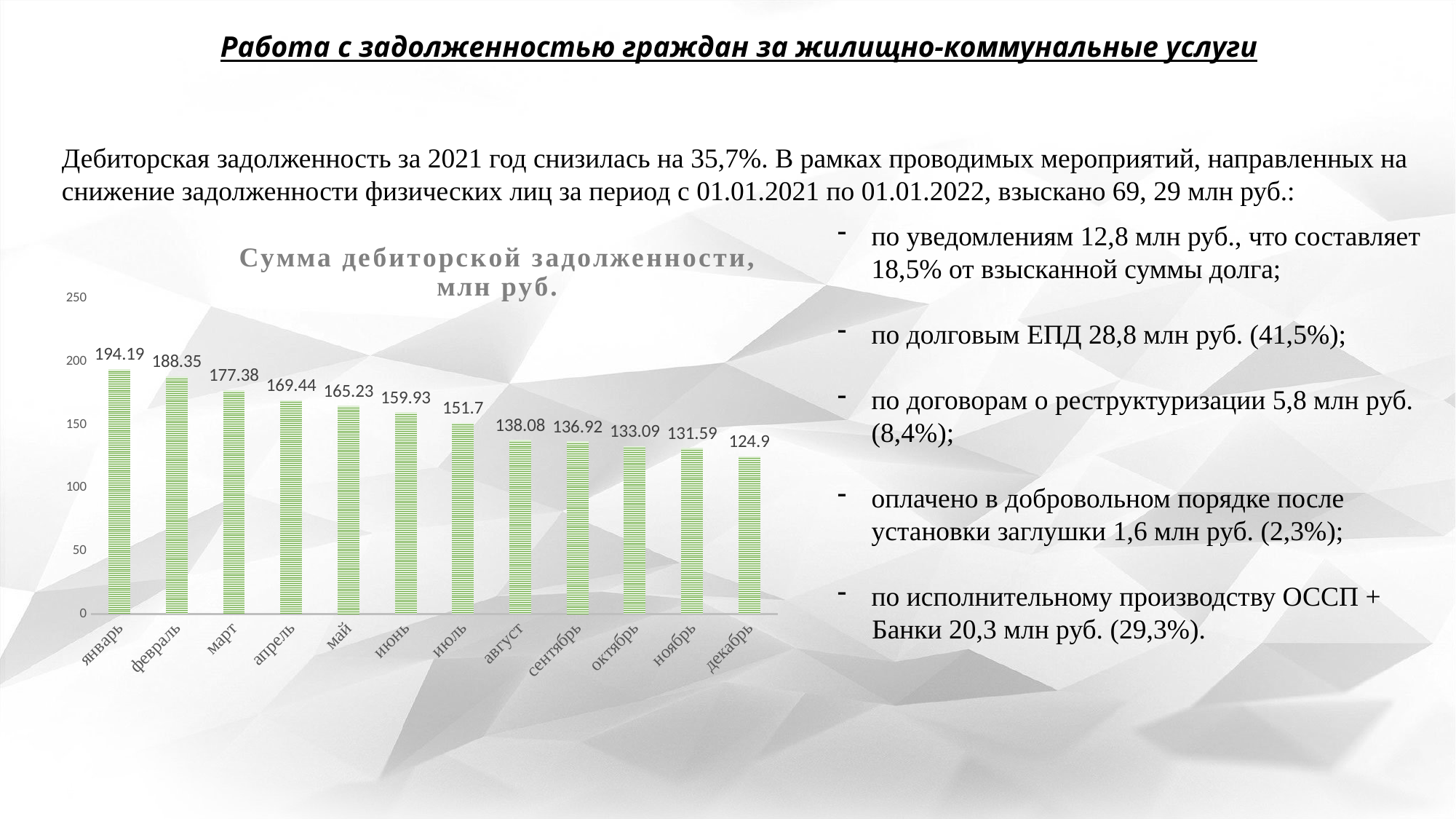
What is the difference between the values for январь and декабрь? 69.29 What is the value for декабрь? 124.9 Which is larger, the value for март or the value for май? март What kind of chart is shown? bar chart Which month has the lowest value? декабрь What is the value for июль? 151.7 Do the values rise or fall from январь to декабрь? fall Is the value for август greater or less than 150? less How many months are shown on the x axis? 12 What is the title of the chart? Сумма дебиторской задолженности, млн руб. What is the value for январь? 194.19 Which month has the highest value? январь